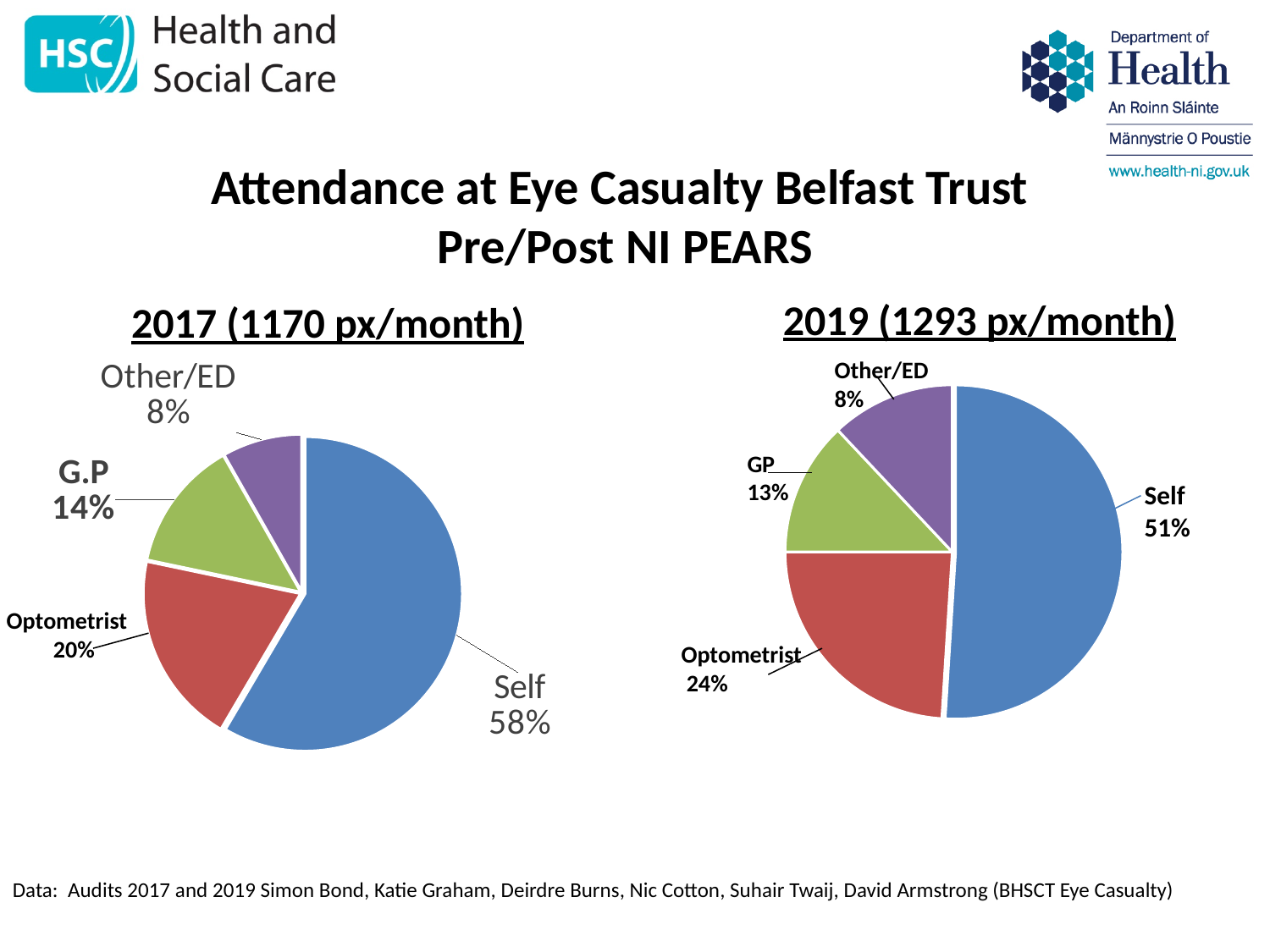
In the 2017 (1170 px/month) pie chart, what share of attendances is Self? 58% What type of chart is used for the 2019 (1293 px/month) data? Pie chart In the 2017 (1170 px/month) pie chart, what colour is the Self slice? Blue In the 2017 (1170 px/month) pie chart, which category has the largest share? Self In the 2019 (1293 px/month) pie chart, which category has the smallest share? Other/ED In the 2019 (1293 px/month) pie chart, what is the difference between the Optometrist share and the GP share? 11% What is the difference between the Self share in the 2017 pie chart and the Self share in the 2019 pie chart? 7% In the 2019 (1293 px/month) pie chart, what share of attendances is Optometrist? 24% Which is larger: the Optometrist share in the 2017 pie chart or the Optometrist share in the 2019 pie chart? 2019 In the 2019 (1293 px/month) pie chart, what share of attendances is Other/ED? 8% How many categories are shown in the 2017 (1170 px/month) pie chart? 4 In the 2017 (1170 px/month) pie chart, what share of attendances is G.P? 14%